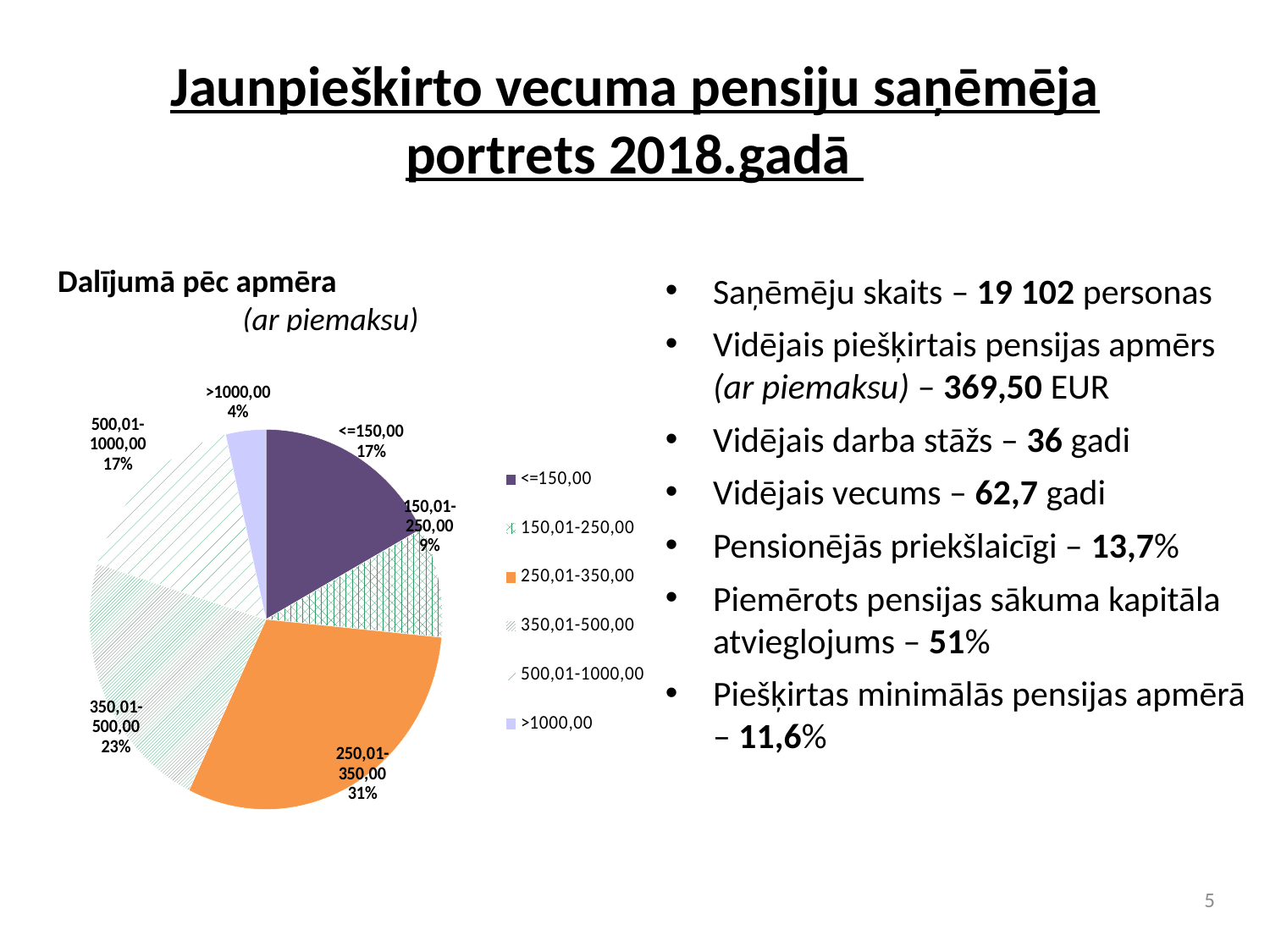
What kind of chart is shown on the slide? pie chart How many entries does the legend of the pie chart list? 6 What share of the pie does the 150,01-250,00 slice represent? 9% What is the title of the pie chart? Dalījumā pēc apmēra (ar piemaksu) What is the difference in percentage points between the 250,01-350,00 slice and the 350,01-500,00 slice? 8 How many categories does the pie chart have? 6 Which category has the largest slice of the pie? 250,01-350,00 Which slice is larger, <=150,00 or 150,01-250,00? <=150,00 What share of the pie does the >1000,00 slice represent? 4% What share of the pie does the 350,01-500,00 slice represent? 23% Which category has the smallest slice of the pie? >1000,00